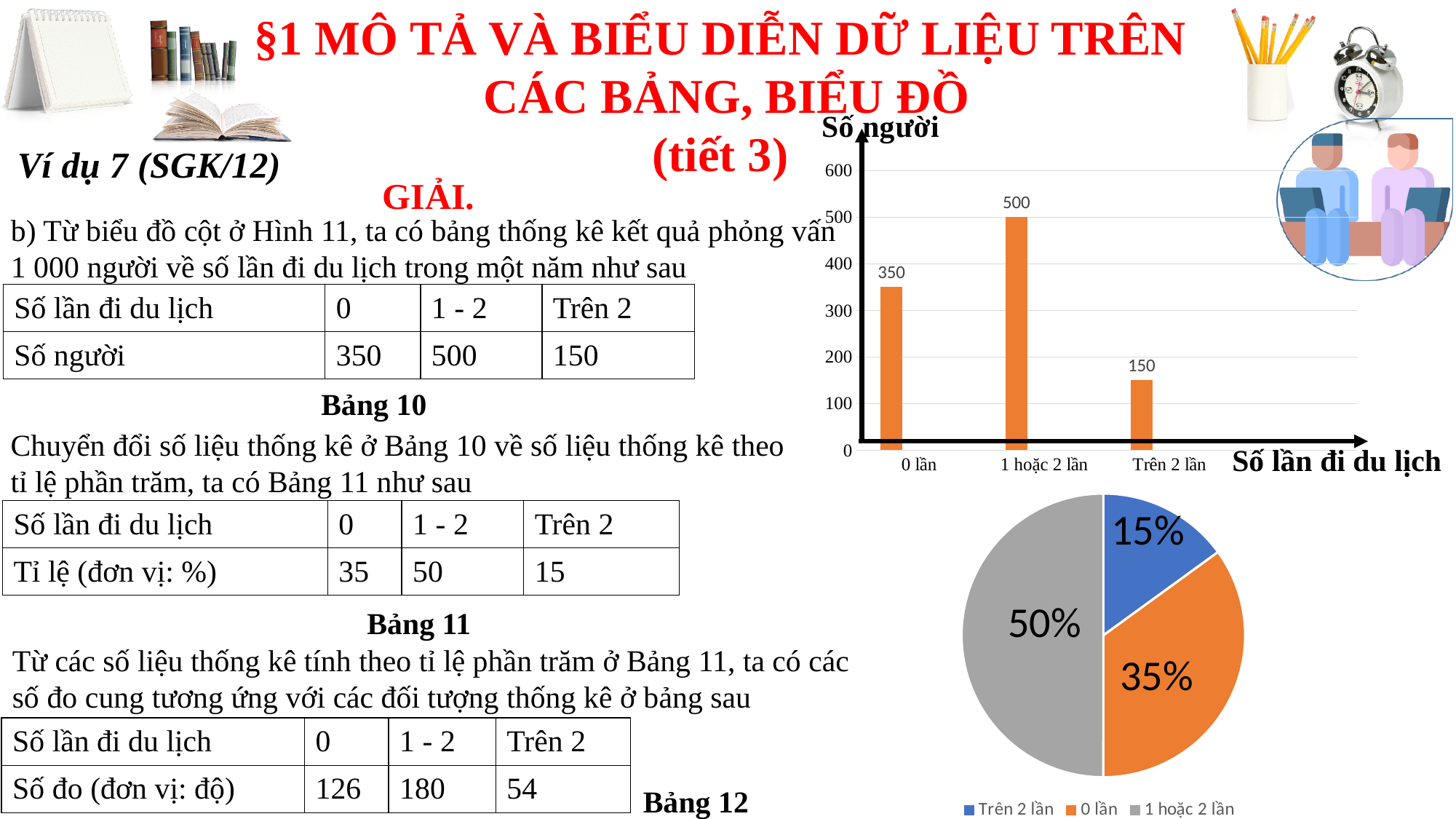
In the pie chart at the bottom right, what share does "0 lần" have? 35% In the bar chart at the top right, which is larger: the value for "0 lần" or the value for "Trên 2 lần"? 0 lần How many entries does the legend of the pie chart at the bottom right list? 3 In the bar chart at the top right, what is the difference between the values for "1 hoặc 2 lần" and "0 lần"? 150 In the bar chart at the top right, what is the value for "Trên 2 lần"? 150 In the pie chart at the bottom right, what share does "1 hoặc 2 lần" have? 50% In the bar chart at the top right, which category has the lowest value? Trên 2 lần In the bar chart at the top right, which category has the highest value? 1 hoặc 2 lần In the bar chart at the top right, what is the value for "0 lần"? 350 In the bar chart at the top right, what is the value for "1 hoặc 2 lần"? 500 What kind of chart is the chart at the top right of the slide? Bar chart How many categories are shown in the bar chart at the top right? 3